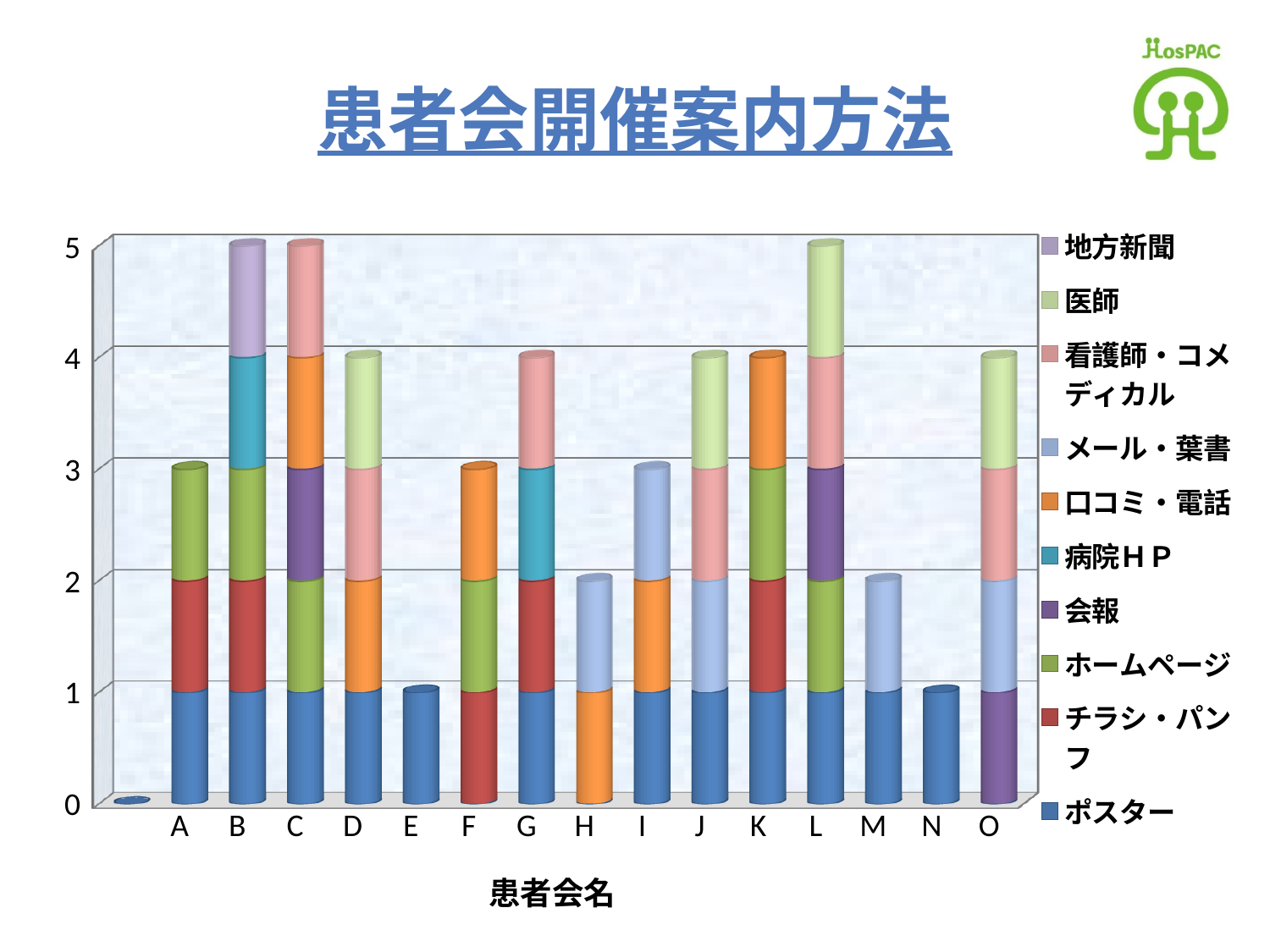
What is the value of the ポスター segment for patient group A? 1 How many series does the legend list? 10 What is the total height of the stacked bar for patient group D? 4 Is the total for patient group H greater or less than 3? less How many patient groups are labeled on the x axis? 15 What is the label of the x axis? 患者会名 What is the total height of the stacked bar for patient group E? 1 What kind of chart is shown on the slide? stacked bar chart Which has a larger total, patient group L or patient group M? L What is the difference between the total for patient group C and the total for patient group N? 4 What is the title of the chart? 患者会開催案内方法 What is the total height of the stacked bar for patient group B? 5